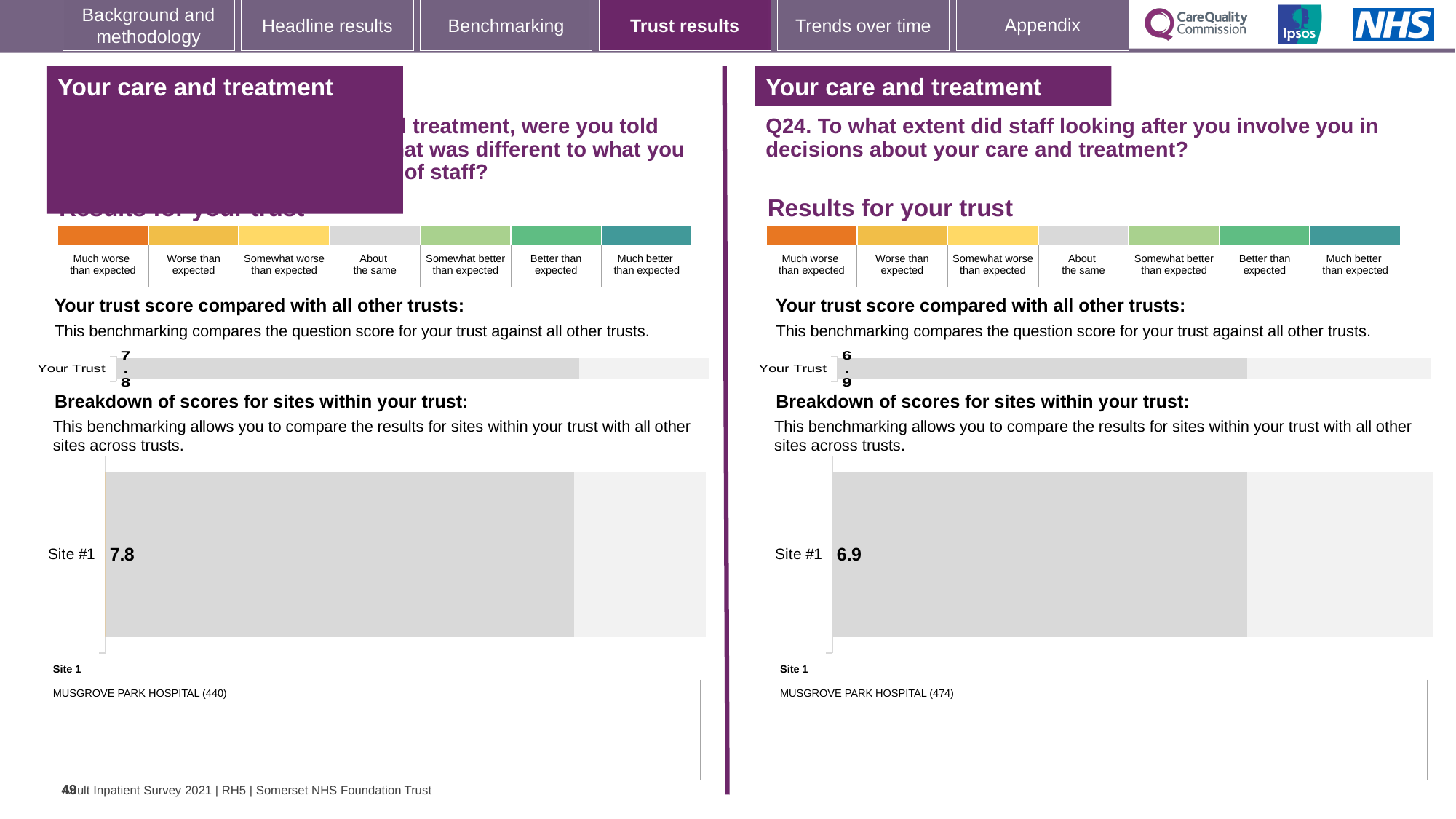
On the right half of the slide (Q24), in the 'Breakdown of scores for sites within your trust' chart, what is the score for Site #1? 6.9 How many sites are shown in the 'Breakdown of scores for sites within your trust' chart on the left half of the slide? 1 How many sites are shown in the 'Breakdown of scores for sites within your trust' chart on the right half of the slide? 1 On the left half of the slide, in the 'Your trust score compared with all other trusts' chart, what is the value for Your Trust? 7.8 On the right half of the slide (Q24), in the 'Your trust score compared with all other trusts' chart, what is the value for Your Trust? 6.9 On the left half of the slide, which hospital is listed as Site 1 below the site breakdown chart? MUSGROVE PARK HOSPITAL (440) What is the difference between the Site #1 score on the left half of the slide (7.8) and the Site #1 score on the right half (6.9)? 0.9 What type of chart is used for the 'Breakdown of scores for sites within your trust' on the left half of the slide? Bar chart What type of chart is used to show the Your Trust score on the right half of the slide? Bar chart On the right half of the slide, which hospital is listed as Site 1 below the site breakdown chart? MUSGROVE PARK HOSPITAL (474) Which is larger: the Your Trust score on the left half of the slide or the Your Trust score on the right half (Q24)? Left half (7.8) On the left half of the slide, in the 'Breakdown of scores for sites within your trust' chart, what is the score for Site #1? 7.8